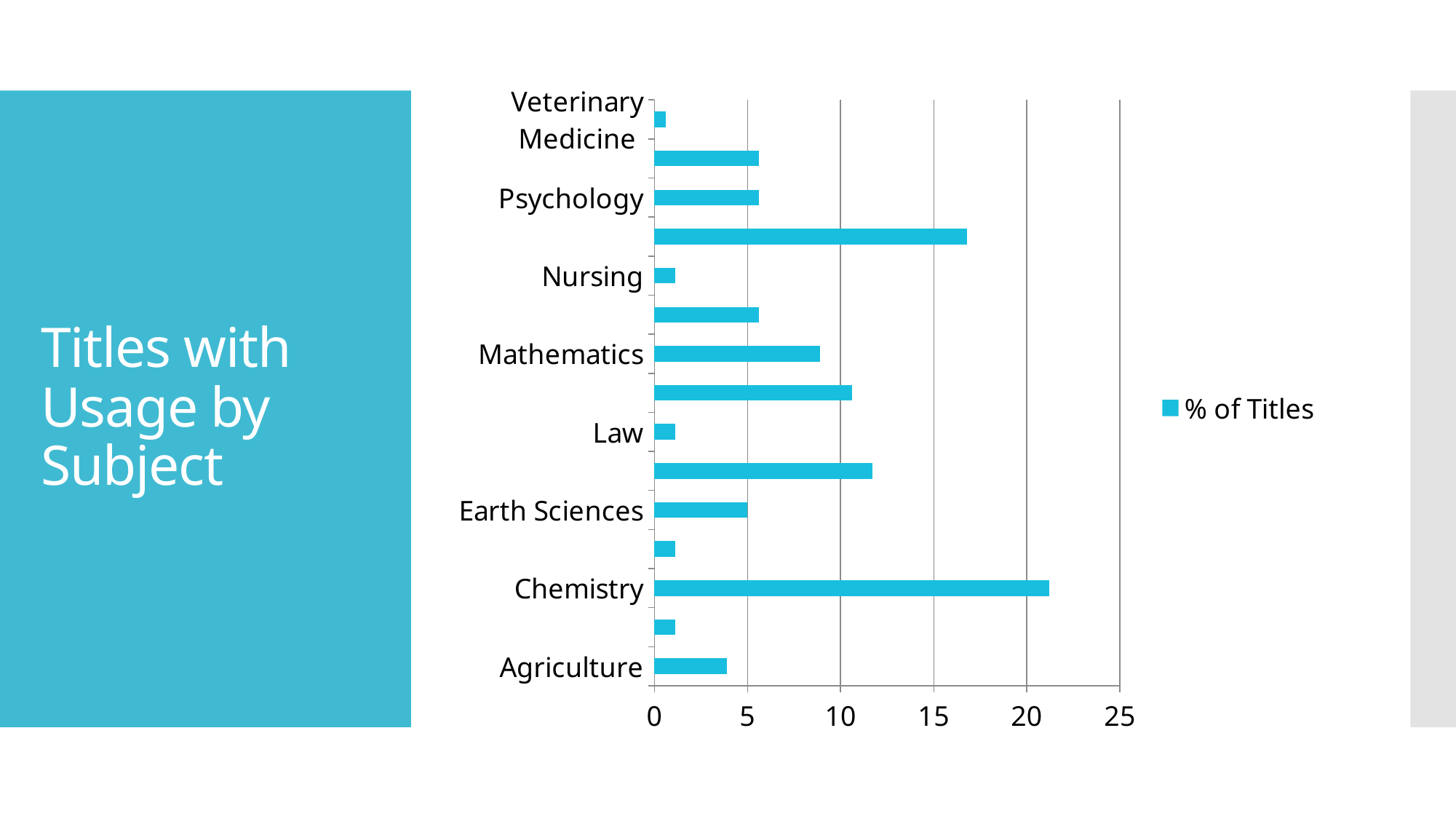
Is the value for Law greater or less than 5? less How many series does the legend list? 1 Is the value for Mathematics greater or less than 10? less What is the title of the slide containing the chart? Titles with Usage by Subject Which labelled subject has the highest % of Titles? Chemistry Is the value for Agriculture greater or less than 5? less What kind of chart is shown on the slide? Bar chart Which has a higher % of Titles, Chemistry or Mathematics? Chemistry What is the name of the series shown in the legend? % of Titles How many subject labels are shown on the vertical axis? 8 Which has a higher % of Titles, Mathematics or Psychology? Mathematics